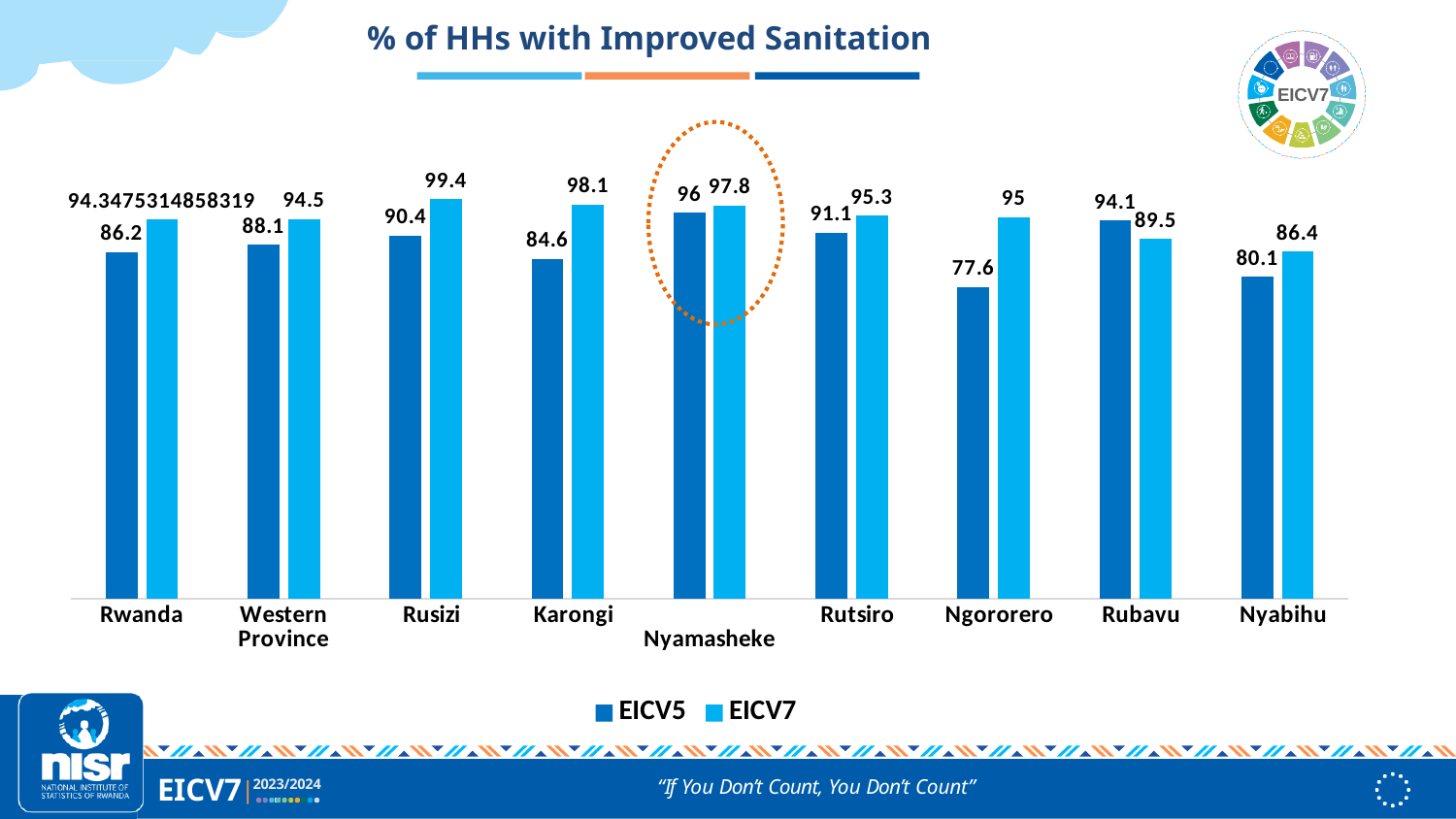
Which category has the highest EICV5 value? Nyamasheke What is the EICV7 value for Nyabihu? 86.4 How many series does the legend list? 2 Which category has the lowest EICV5 value? Ngororero What is the EICV5 value for Ngororero? 77.6 Which category has the highest EICV7 value? Rusizi What type of chart is shown on the slide? Bar chart What is the EICV7 value for Rusizi? 99.4 For Rubavu, which is larger: the EICV5 value or the EICV7 value? EICV5 What is the EICV5 value for Karongi? 84.6 How many categories are shown on the x axis? 9 What is the difference between the EICV7 and EICV5 values for Karongi? 13.5